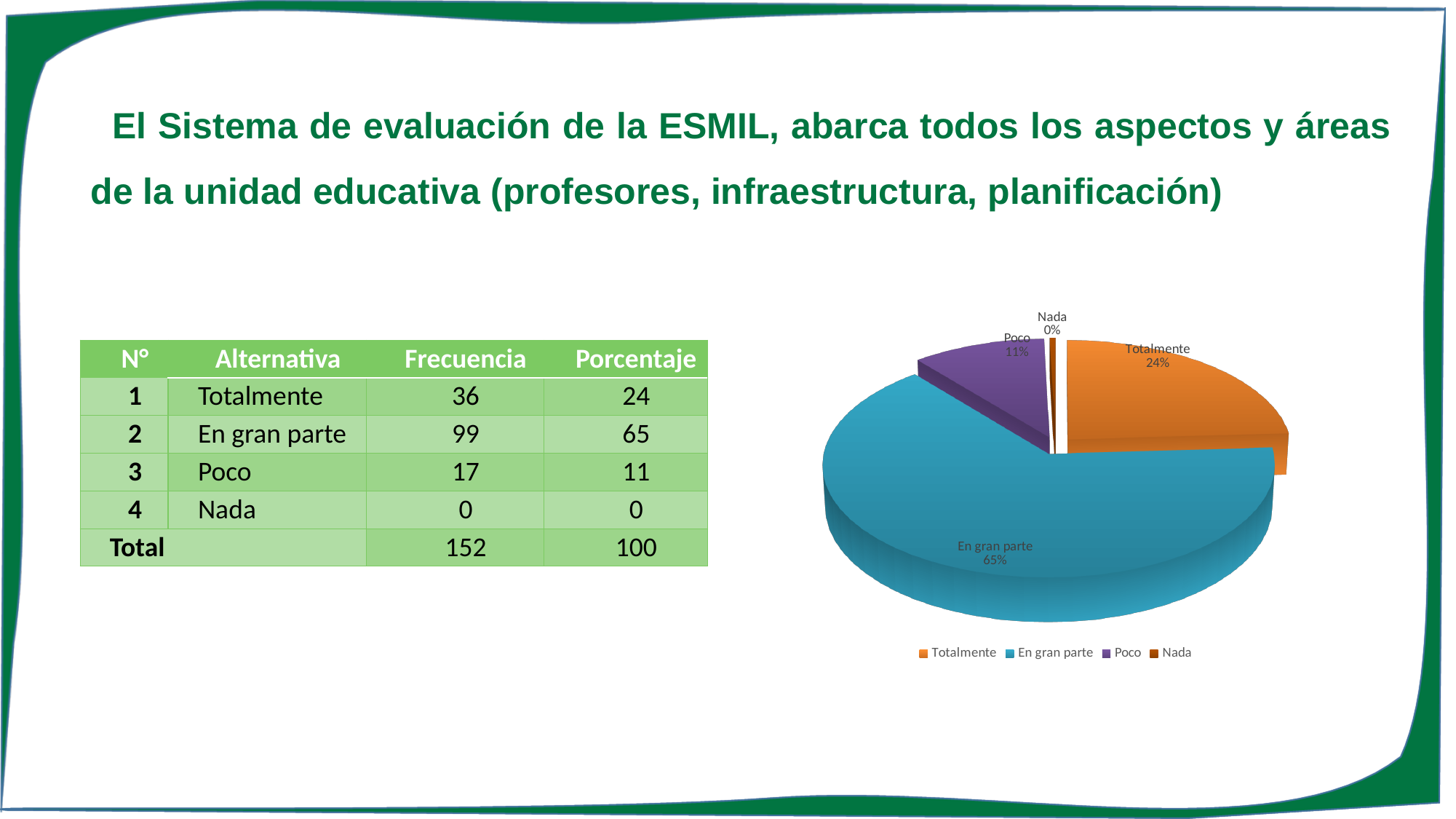
What percentage does the pie chart show for Totalmente? 24% What is the difference in percentage points between En gran parte and Totalmente in the pie chart? 41 What percentage does the pie chart show for Nada? 0% How many categories does the pie chart show? 4 Which slice is larger in the pie chart, Totalmente or Poco? Totalmente How many entries does the pie chart legend list? 4 What colour is the En gran parte slice in the pie chart? blue What kind of chart is shown on the slide? pie chart Which category has the largest slice in the pie chart? En gran parte What percentage does the pie chart show for Poco? 11% Which category has the smallest slice in the pie chart? Nada What percentage does the pie chart show for En gran parte? 65%